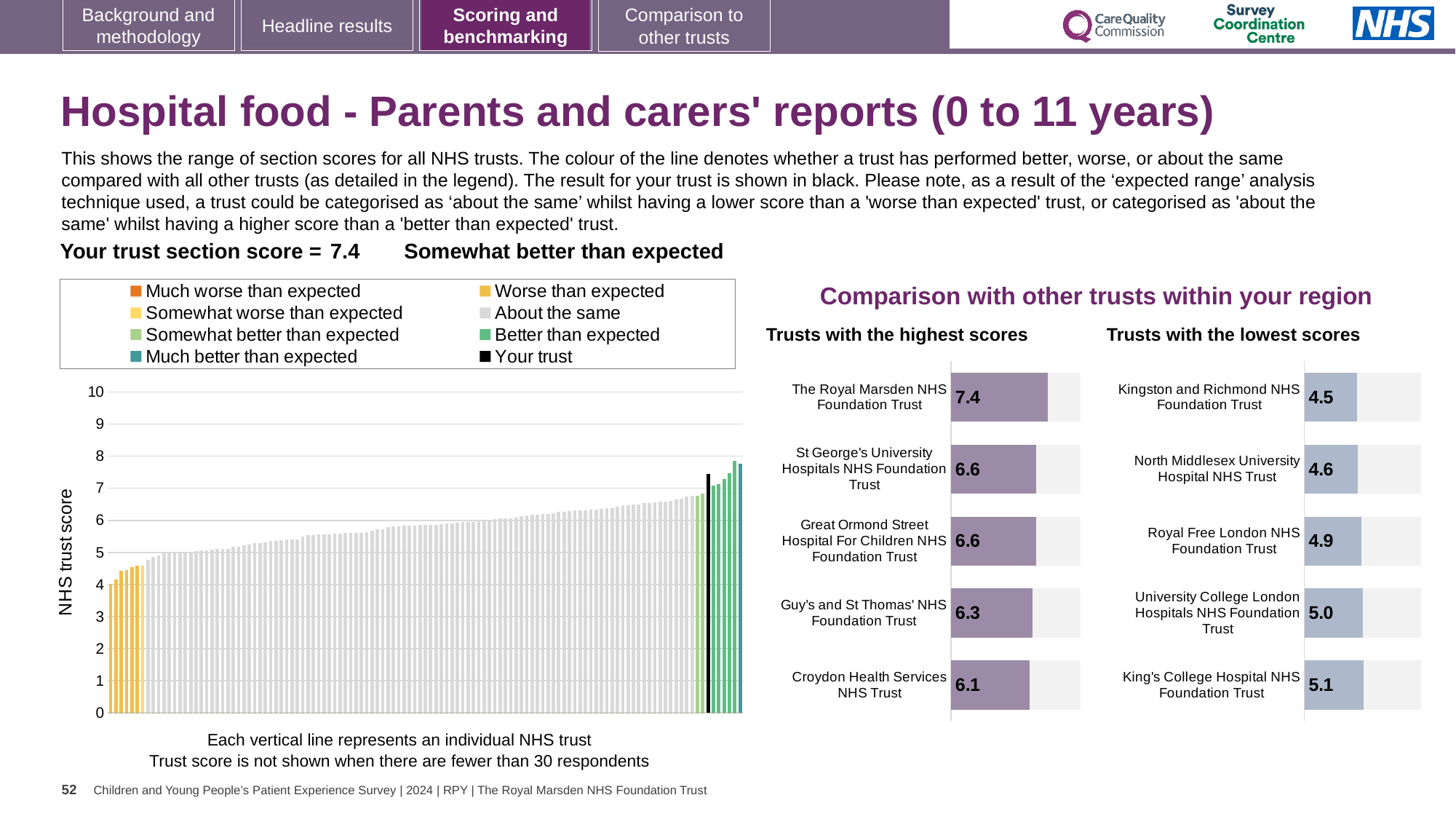
In the 'Trusts with the lowest scores' chart, which trust has the lowest score? Kingston and Richmond NHS Foundation Trust How many entries does the legend of the main 'NHS trust score' chart on the left list? 8 In the 'Trusts with the lowest scores' chart, what is the score for Royal Free London NHS Foundation Trust? 4.9 In the 'Trusts with the lowest scores' chart, which has the larger score: North Middlesex University Hospital NHS Trust or University College London Hospitals NHS Foundation Trust? University College London Hospitals NHS Foundation Trust In the 'Trusts with the highest scores' chart, what is the score for Croydon Health Services NHS Trust? 6.1 In the main 'NHS trust score' chart on the left, is the value for the black 'Your trust' bar greater or less than 7? greater In the 'Trusts with the lowest scores' chart, what is the difference between the scores of King's College Hospital NHS Foundation Trust and Kingston and Richmond NHS Foundation Trust? 0.6 How many trusts are listed in the 'Trusts with the highest scores' chart? 5 In the 'Trusts with the highest scores' chart, what is the score for The Royal Marsden NHS Foundation Trust? 7.4 In the main 'NHS trust score' chart on the left, do the bar values rise or fall from left to right? rise In the 'Trusts with the highest scores' chart, which trust has the highest score? The Royal Marsden NHS Foundation Trust In the 'Trusts with the highest scores' chart, what is the difference between the scores of The Royal Marsden NHS Foundation Trust and Croydon Health Services NHS Trust? 1.3